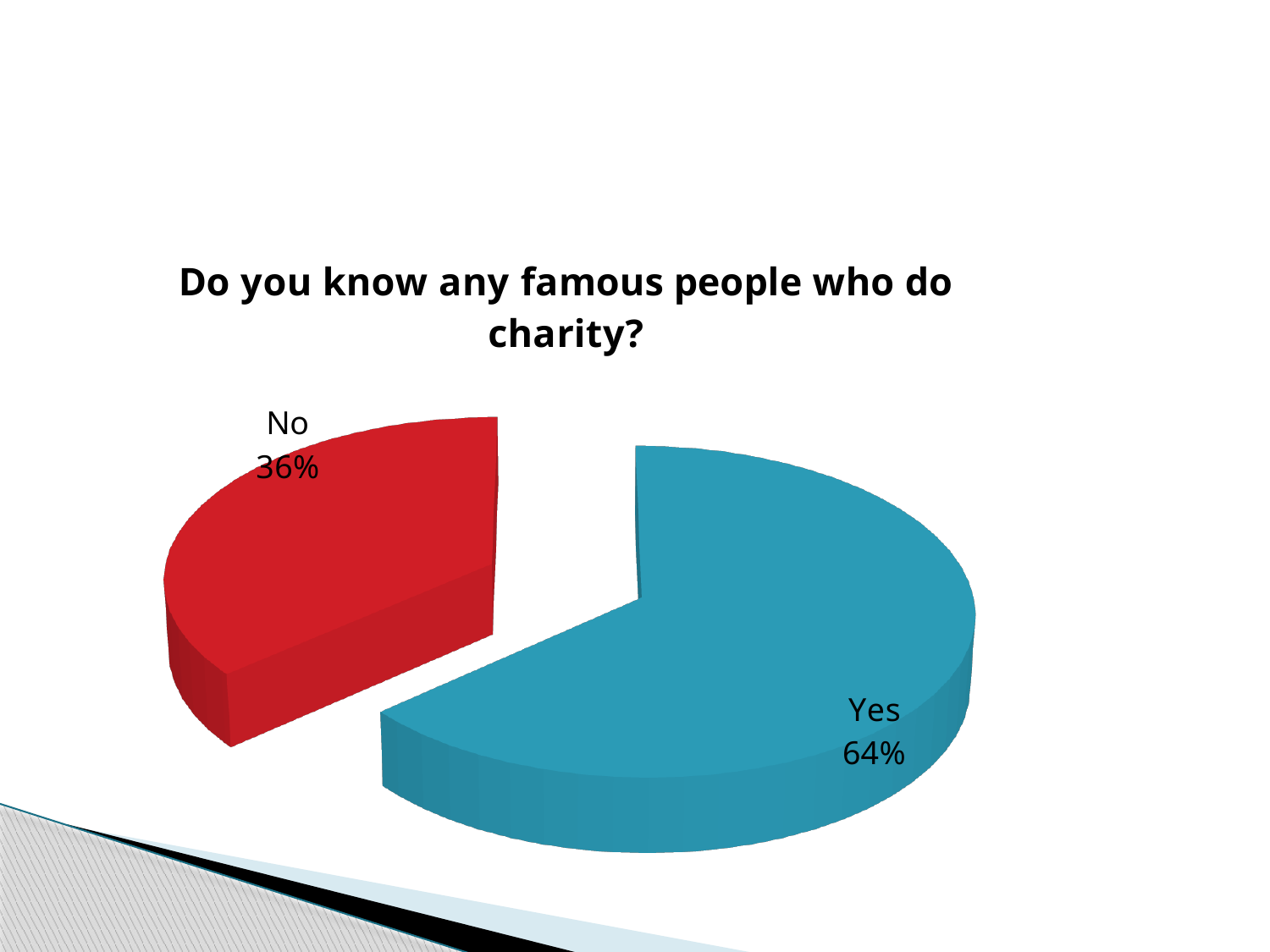
What percentage of respondents answered No? 36% What is the title of the chart? Do you know any famous people who do charity? What kind of chart is shown on the slide? Pie chart Which answer has the largest share of the pie? Yes How many slices does the pie chart have? 2 What share of the pie does the No slice represent? 36% What colour is the Yes slice? Blue What is the difference in percentage points between the Yes and No slices? 28 Which slice is larger, Yes or No? Yes What percentage of respondents answered Yes? 64% Which answer has the smallest share of the pie? No